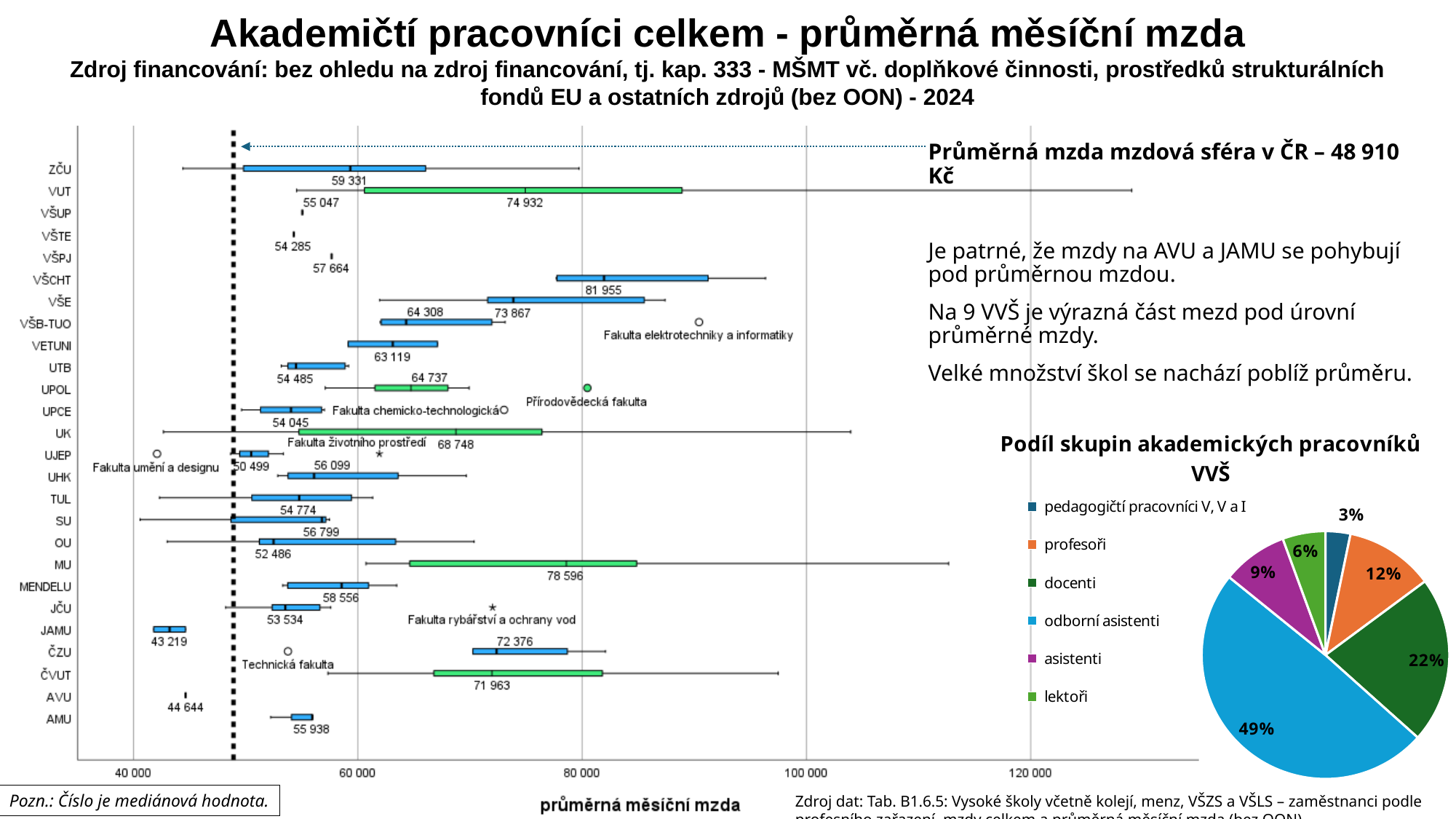
How many groups does the legend of the pie chart 'Podíl skupin akademických pracovníků VVŠ' list? 6 In the box plot of average monthly salary, what is the median value shown for JAMU? 43 219 In the pie chart 'Podíl skupin akademických pracovníků VVŠ', which group has the largest share? odborní asistenti In the box plot of average monthly salary, what is the median value shown for VŠCHT? 81 955 According to the annotation on the box plot, what is the average wage in the wage sphere in the Czech Republic? 48 910 Kč In the box plot of average monthly salary, which has the larger median value, VUT or MU? MU How many schools are listed on the vertical axis of the box plot of average monthly salary? 26 In the box plot of average monthly salary, which school has the lowest labelled median value? JAMU In the box plot of average monthly salary, what is the difference between the median values of VŠCHT and JAMU? 38 736 In the box plot of average monthly salary, which school has the highest labelled median value? VŠCHT In the pie chart 'Podíl skupin akademických pracovníků VVŠ', what share do docenti have? 22% In the box plot of average monthly salary, what is the median value shown for MU? 78 596